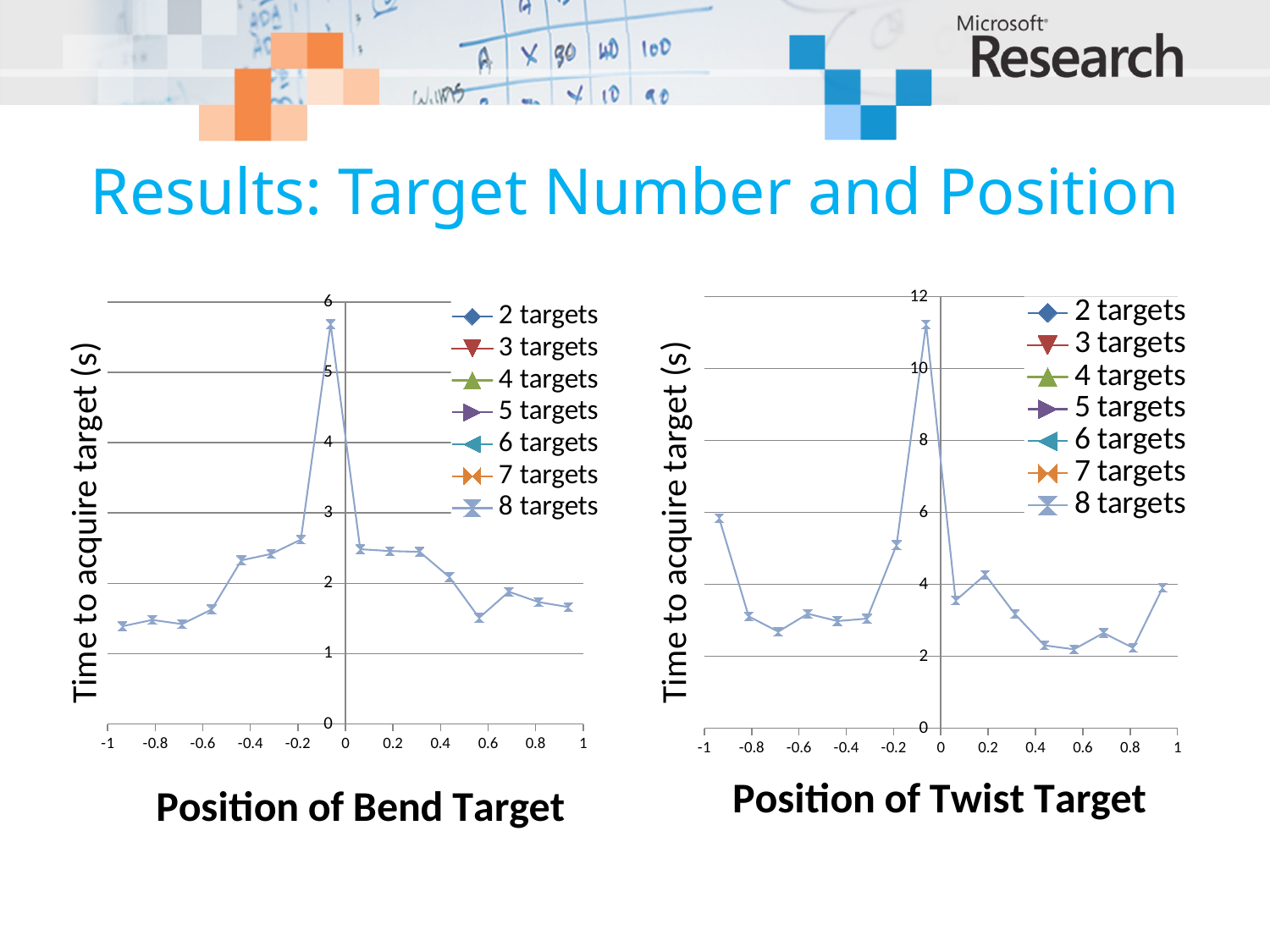
How many series does the legend of the 'Position of Twist Target' chart list? 7 In the 'Position of Twist Target' chart, which is larger: the value at the leftmost point (near -1) or the value at the rightmost point (near 1)? the leftmost point (near -1) In the 'Position of Twist Target' chart, is the value at the point near 0.6 greater or less than 4? less In the 'Position of Twist Target' chart, is the peak value of the plotted line greater or less than 10? greater In the 'Position of Twist Target' chart, do the values rise or fall from x = -1 to x = -0.6? fall What kind of chart is the 'Position of Bend Target' chart? line chart What is the highest y-axis tick value shown on the 'Position of Twist Target' chart? 12 In the 'Position of Bend Target' chart, is the value at the leftmost point (near -1) greater or less than 2? less What is the y-axis label of the 'Position of Bend Target' chart? Time to acquire target (s) In the 'Position of Bend Target' chart, do the values generally rise or fall from x = 0.2 to x = 1? fall